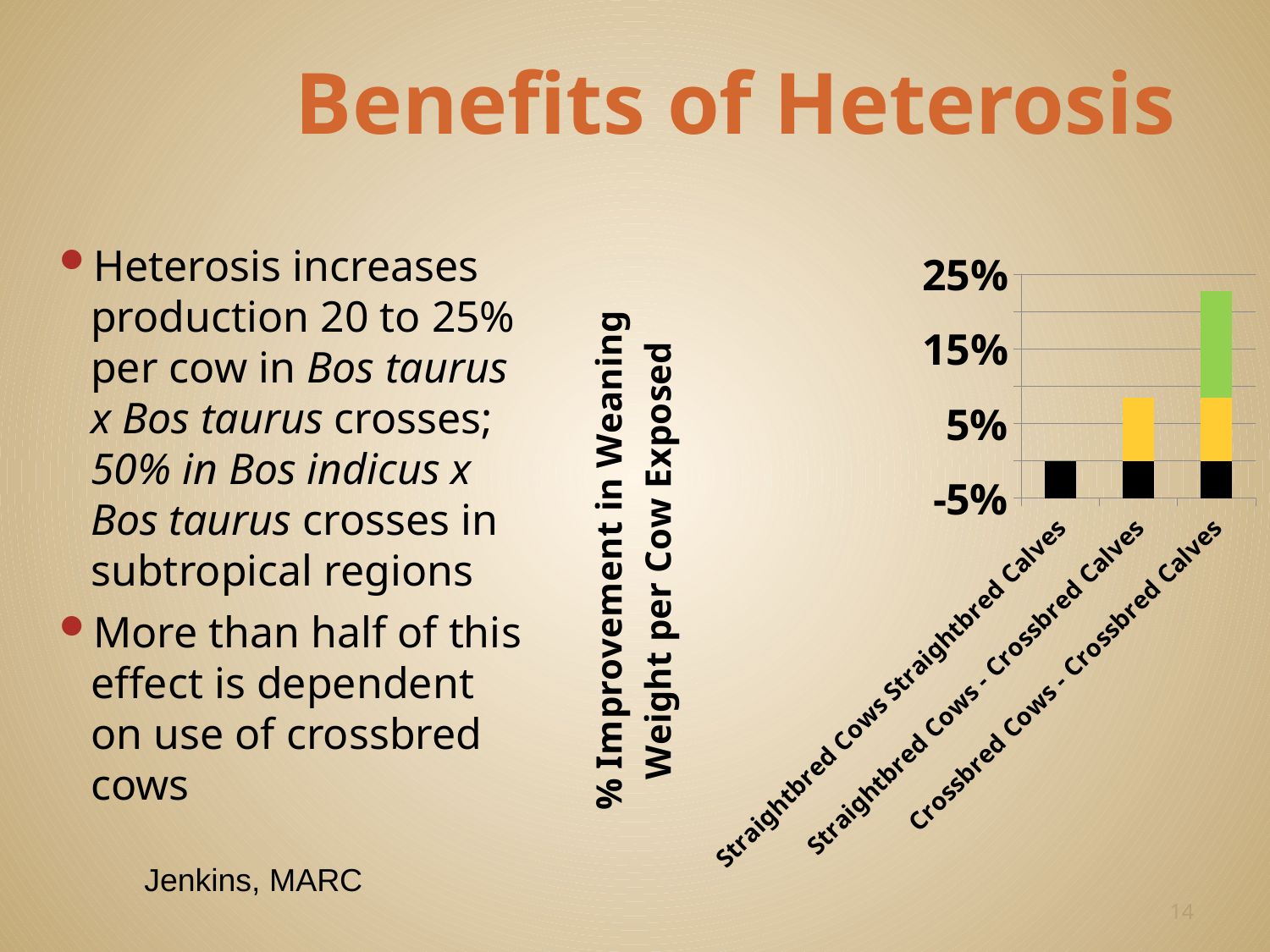
Which bar is taller: Straightbred Cows - Crossbred Calves or Crossbred Cows - Crossbred Calves? Crossbred Cows - Crossbred Calves Is the top of the bar for Straightbred Cows Straightbred Calves greater or less than 5%? less What is the highest value labelled on the vertical axis of the chart? 25% Which category has the tallest bar in the chart? Crossbred Cows - Crossbred Calves Which bar in the chart contains a green segment? Crossbred Cows - Crossbred Calves Is the top of the bar for Crossbred Cows - Crossbred Calves greater or less than 15%? greater What kind of chart is shown on the slide? Bar chart Which category has the shortest bar in the chart? Straightbred Cows Straightbred Calves How many categories are shown on the x axis of the chart? 3 What is the title of the vertical axis of the chart? % Improvement in Weaning Weight per Cow Exposed Is the top of the bar for Straightbred Cows - Crossbred Calves greater or less than 5%? greater Do the bar heights rise or fall moving from left to right along the x axis? Rise